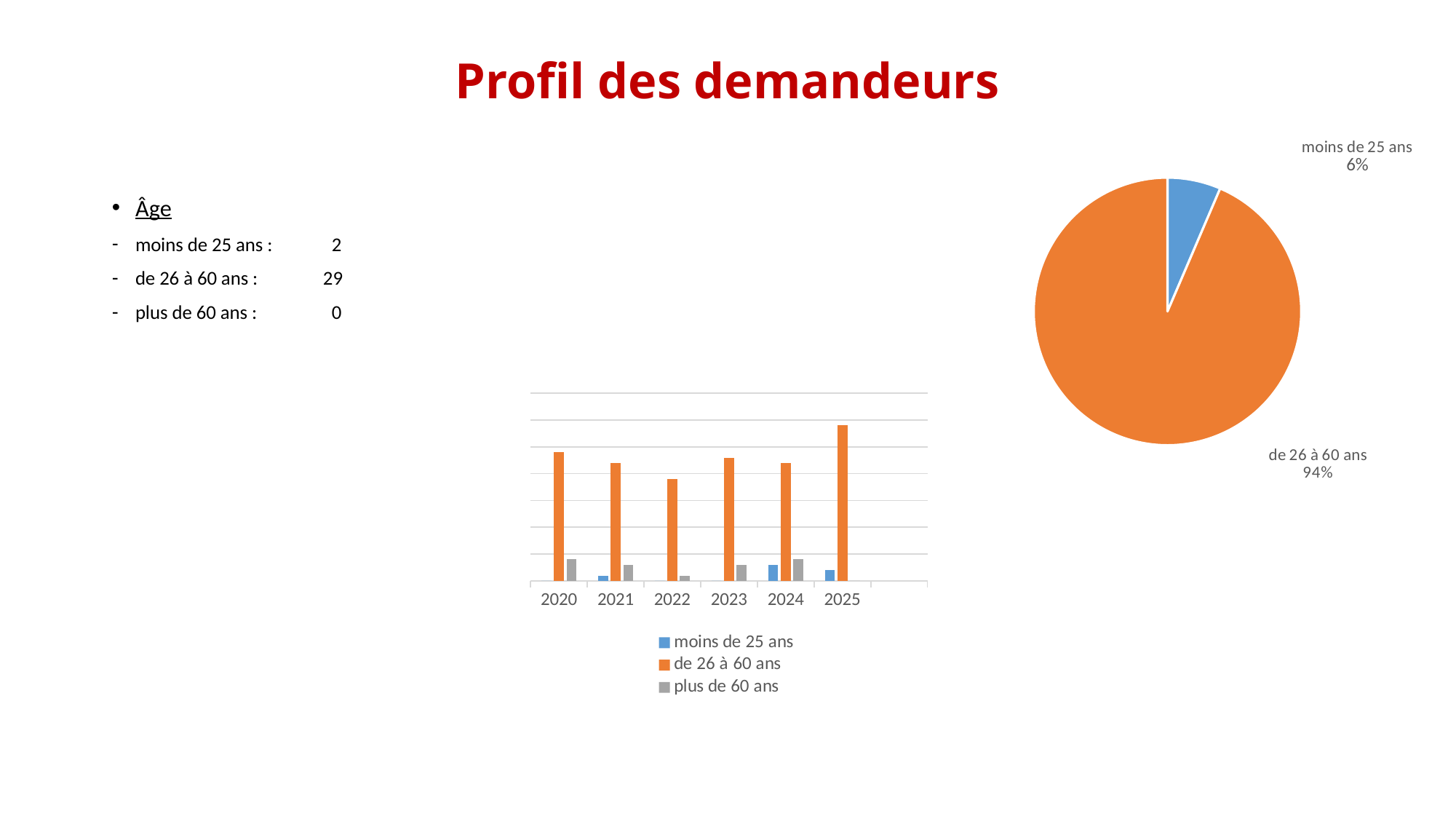
What kind of chart is the chart on the right of the slide? pie chart In the bar chart, which year has the lowest bar for 'de 26 à 60 ans'? 2022 In the bar chart, is the 'moins de 25 ans' bar larger in 2024 or in 2021? 2024 In the bar chart, how many series does the legend list? 3 In the bar chart, how many years are shown on the x axis? 6 In the pie chart, which slice is the largest? de 26 à 60 ans In the bar chart, which series has the tallest bar in every year? de 26 à 60 ans In the pie chart, what share is shown for 'de 26 à 60 ans'? 94% In the bar chart, is the 'de 26 à 60 ans' bar larger in 2025 or in 2022? 2025 What kind of chart is the chart in the middle of the slide? bar chart In the bar chart, which year has the highest bar for 'de 26 à 60 ans'? 2025 In the pie chart, what share is shown for 'moins de 25 ans'? 6%